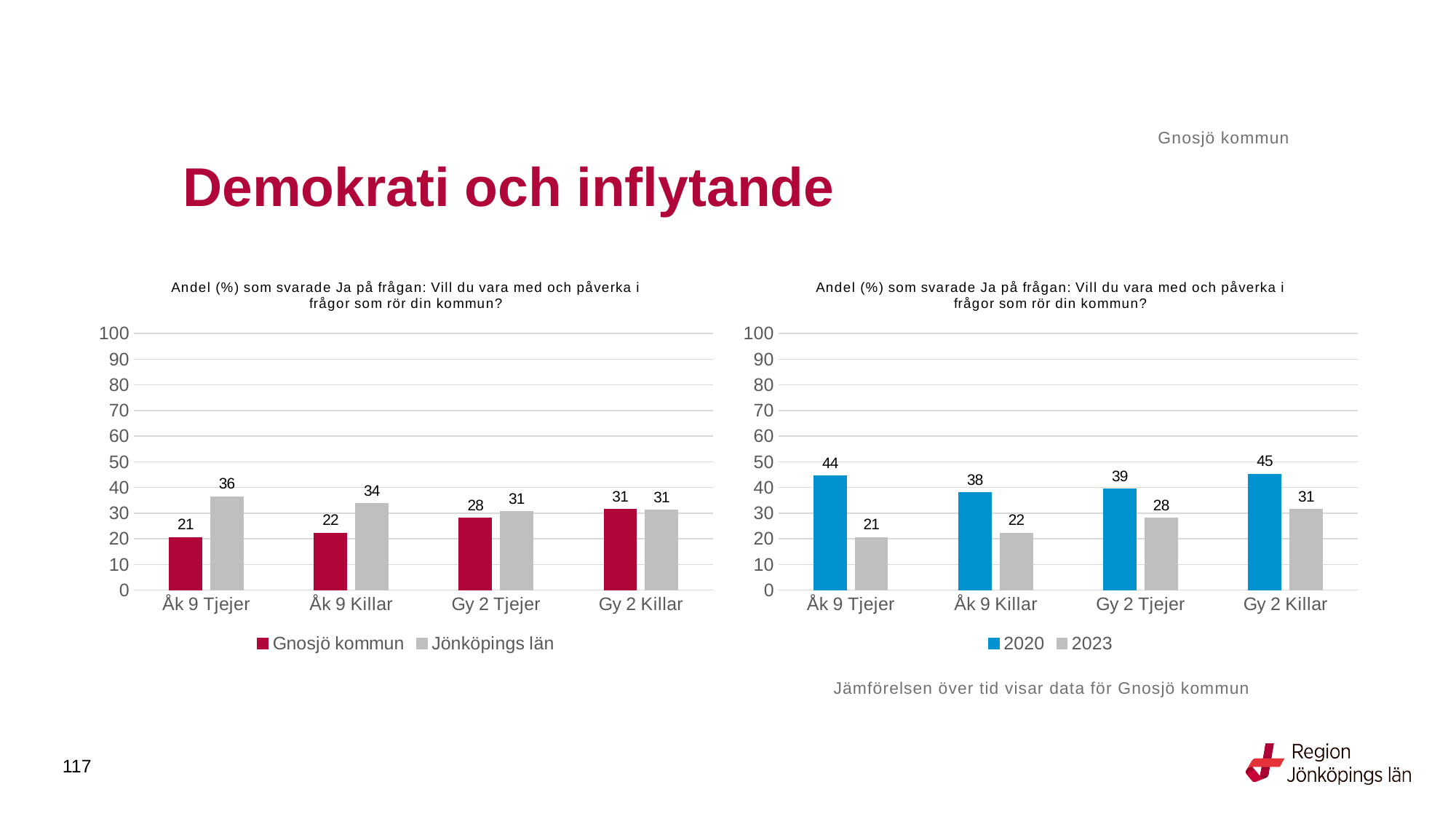
In the right chart, what is the value for 2023 for Gy 2 Tjejer? 28 In the left chart, which category has the highest value for Jönköpings län? Åk 9 Tjejer In the left chart, what is the value for Jönköpings län for Åk 9 Killar? 34 In the left chart, how many series does the legend list? 2 In the right chart, is the 2020 value for Åk 9 Killar larger or smaller than the 2023 value for Åk 9 Killar? larger What kind of chart is the left chart? bar chart How many categories are shown on the x axis of the right chart? 4 In the right chart, what is the difference between 2020 and 2023 for Åk 9 Tjejer? 23 In the right chart, what is the value for 2020 for Gy 2 Killar? 45 In the left chart, what is the difference between Jönköpings län and Gnosjö kommun for Åk 9 Tjejer? 15 In the right chart, which category has the lowest value for 2023? Åk 9 Tjejer In the left chart, what is the value for Gnosjö kommun for Åk 9 Tjejer? 21